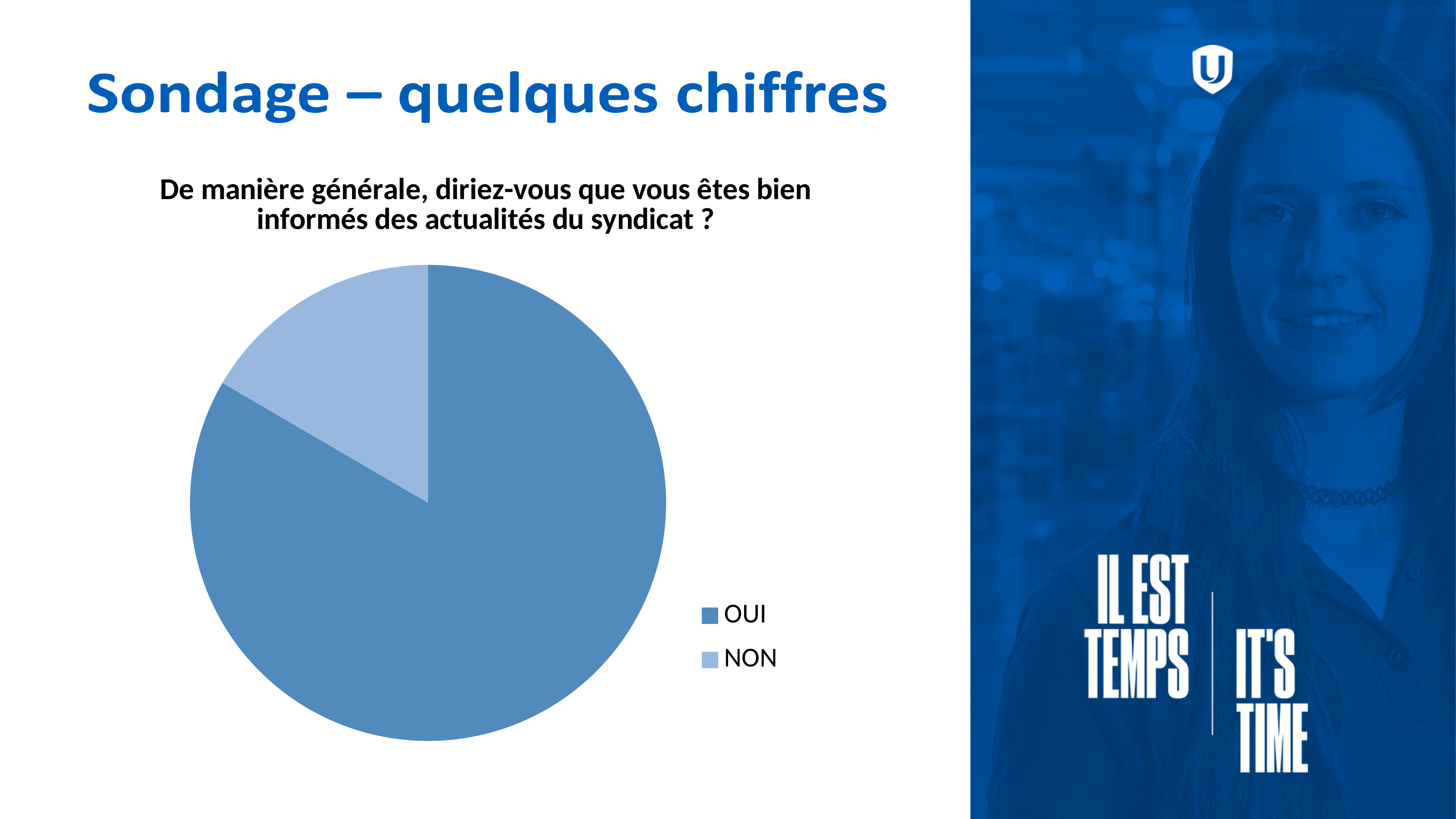
How many slices does the pie chart have? 2 Which slice is larger in the pie chart, OUI or NON? OUI How many entries does the legend of the pie chart list? 2 Which category has the smallest slice in the pie chart? NON Which legend entry is shown in the lighter blue colour in the pie chart? NON What is the title of the pie chart? De manière générale, diriez-vous que vous êtes bien informés des actualités du syndicat ? Which category has the largest slice in the pie chart? OUI Does the OUI slice take up more or less than half of the pie chart? more What kind of chart is shown on the slide? pie chart